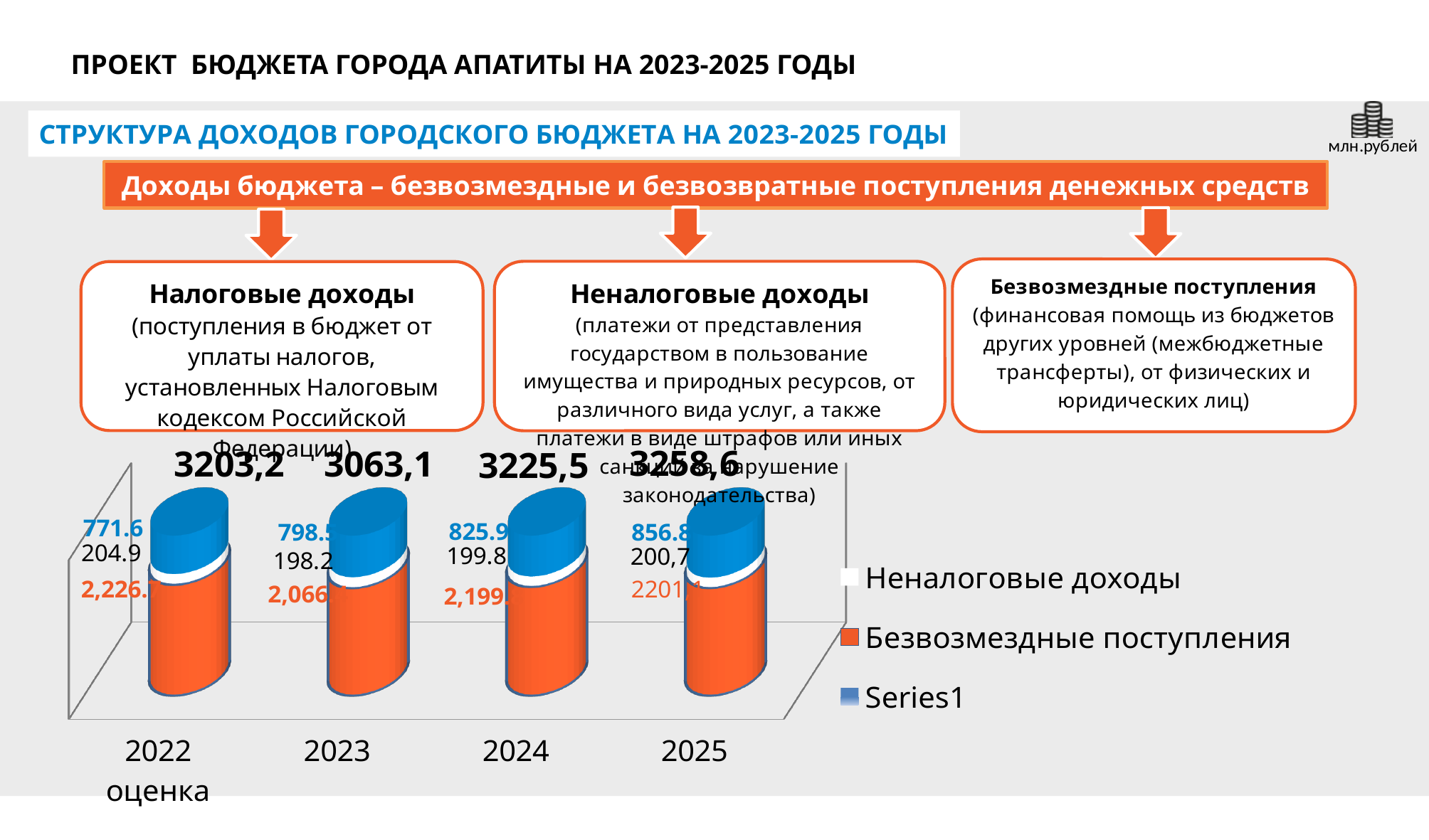
What is the total value shown above the bar for 2025? 3258,6 How many year categories are shown along the x axis of the chart? 4 What is the value of Безвозмездные поступления for 2025? 2201,1 What is the difference between the total for 2025 and the total for 2024? 33,1 Which is larger, the Series1 value for 2022 оценка or for 2025? 2025 What is the value of Неналоговые доходы for 2023? 198.2 How many series does the chart legend list? 3 Which year has the highest total value? 2025 What is the value of Series1 for 2024? 825.9 What kind of chart is shown on the slide? Stacked bar chart What is the total value shown above the bar for 2022 оценка? 3203,2 Which year has the lowest total value? 2023